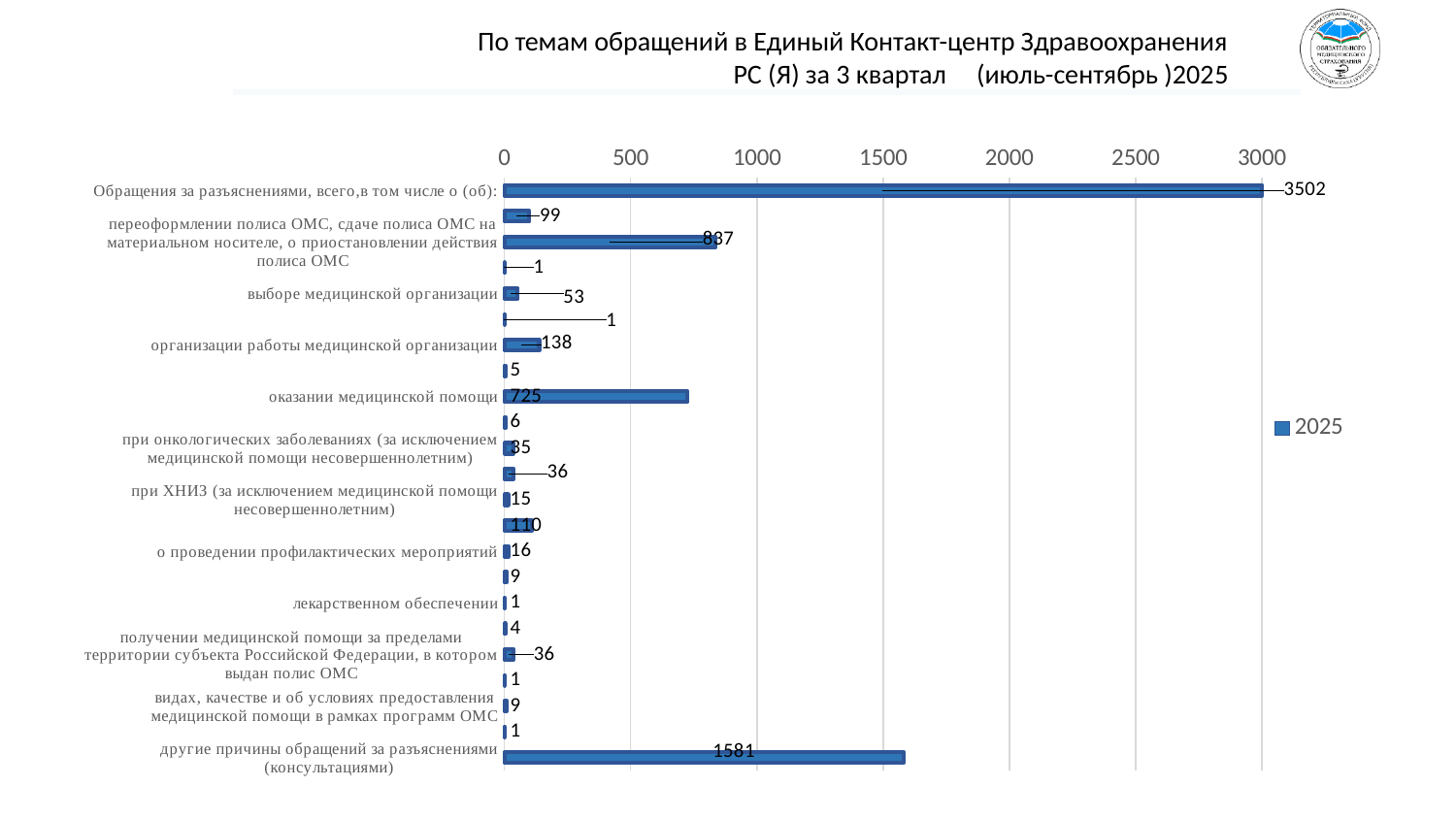
What is the highest tick value shown on the value axis? 3000 Is the value for "другие причины обращений за разъяснениями (консультациями)" greater or less than 1500? greater What is the value for "другие причины обращений за разъяснениями (консультациями)"? 1581 How many series does the legend list? 1 What is the difference between the total (3502) and "другие причины обращений за разъяснениями (консультациями)" (1581)? 1921 What is the value for "переоформлении полиса ОМС, сдаче полиса ОМС на материальном носителе, о приостановлении действия полиса ОМС"? 837 What year is shown in the chart legend? 2025 Which is larger: "переоформлении полиса ОМС..." or "оказании медицинской помощи"? переоформлении полиса ОМС... What type of chart is shown on the slide? bar chart Which category has the highest value? Обращения за разъяснениями, всего, в том числе о (об): What is the value for "оказании медицинской помощи"? 725 What is the value for "Обращения за разъяснениями, всего, в том числе о (об):"? 3502